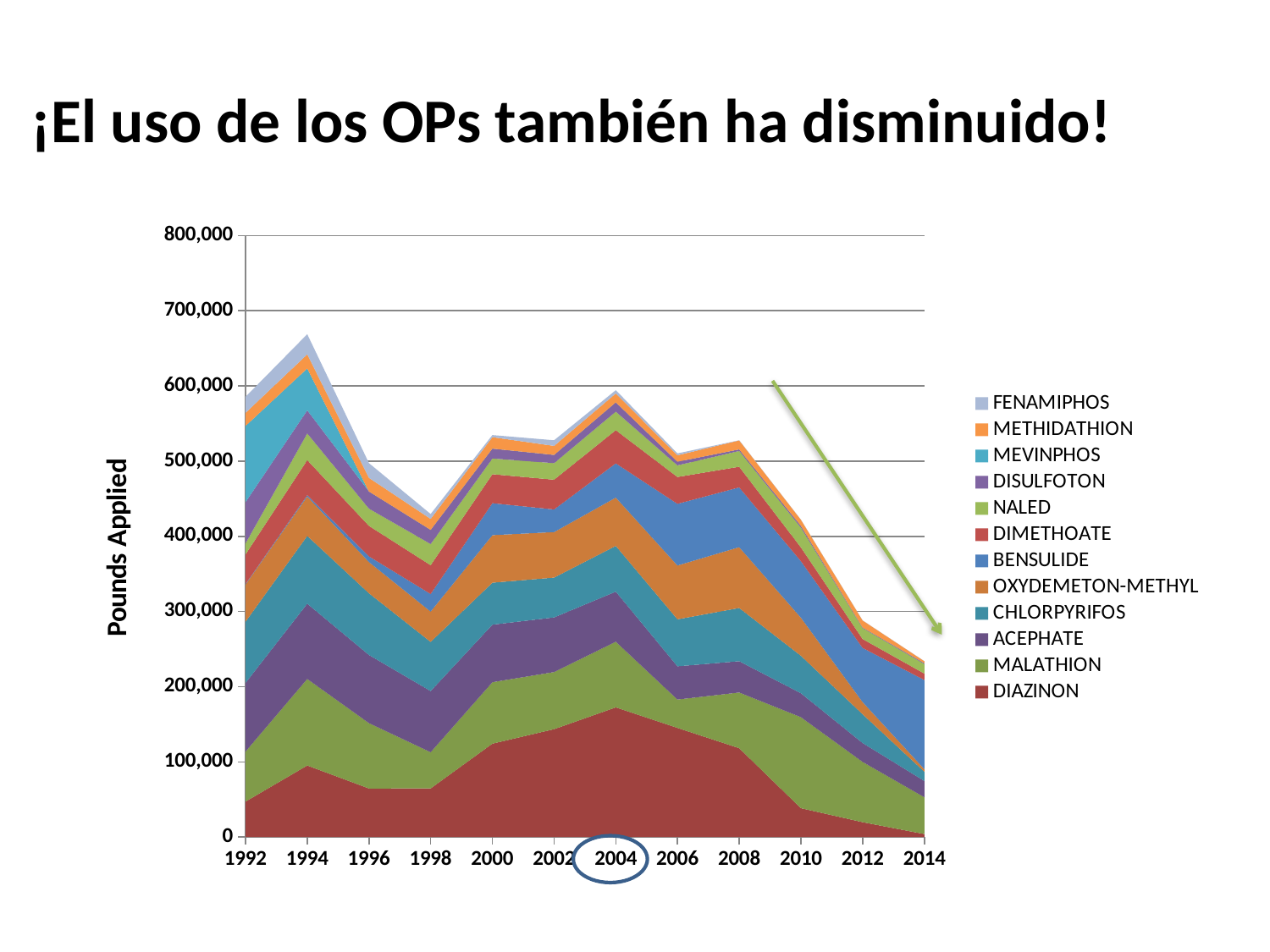
Is the value for DIAZINON in 2004 greater or less than 100,000? greater In which year is the total pounds applied highest? 1994 Is the total pounds applied in 1994 greater or less than 600,000? greater What kind of chart is shown on the slide? Stacked area chart What is the label of the vertical axis? Pounds Applied Is the total pounds applied in 2004 larger or smaller than in 2012? larger Is the total pounds applied in 2014 greater or less than 300,000? less How many series does the chart's legend list? 12 How many years are labelled along the x axis of the chart? 12 Which year is circled on the x axis of the chart? 2004 In which year is the total pounds applied lowest? 2014 Does the total pounds applied rise or fall from 2004 to 2014? fall